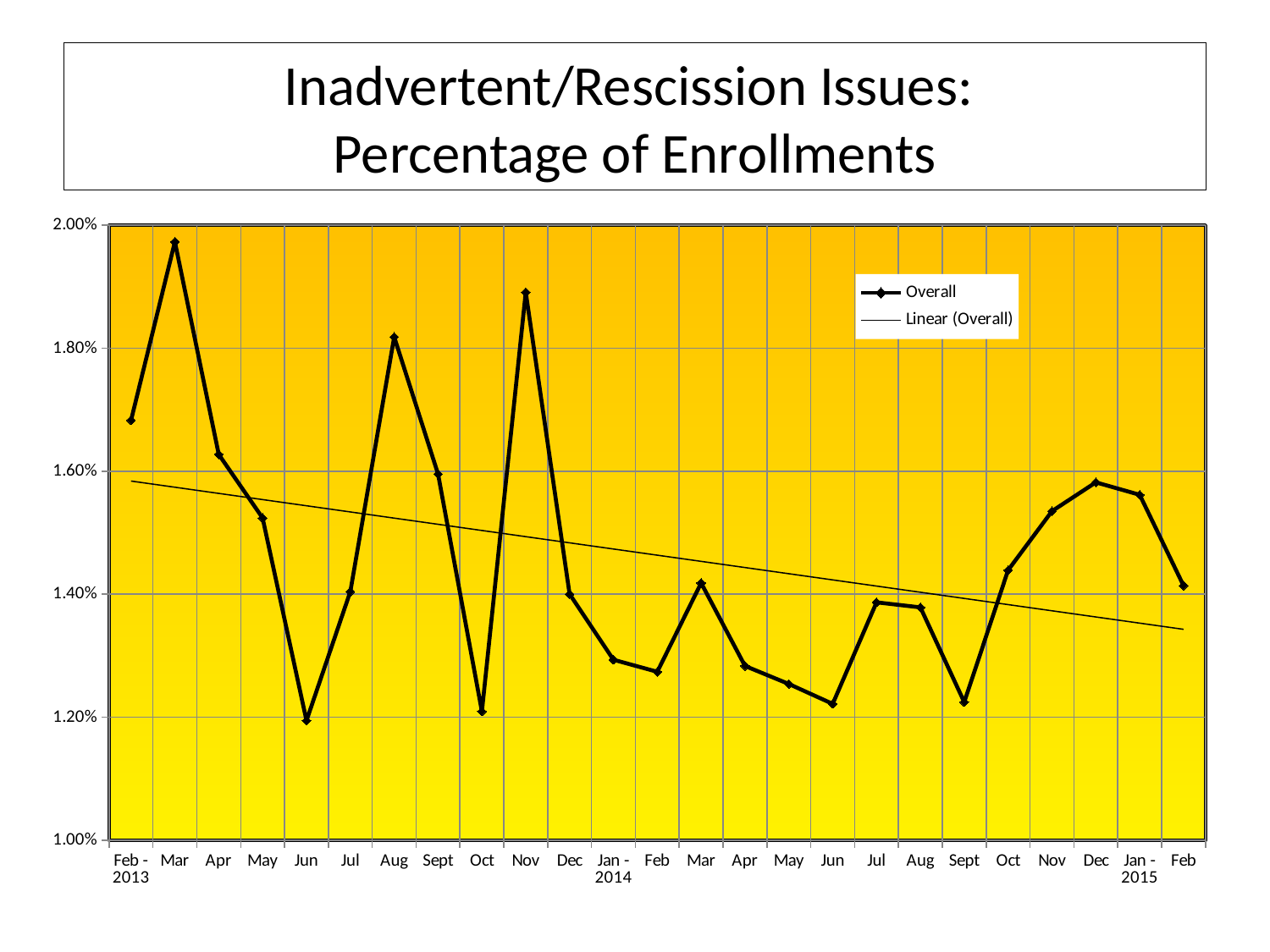
Is the Overall value for Sept 2014 greater or less than 1.40%? less How many entries does the legend list? 2 Which is higher, the Overall value for Mar 2013 or for Nov 2013? Mar 2013 Is the Overall value for Mar 2013 greater or less than 1.80%? greater Which month has the highest Overall value? Mar 2013 Is the Overall value for Jan 2014 greater or less than 1.40%? less What is the title of the chart? Inadvertent/Rescission Issues: Percentage of Enrollments Does the Linear (Overall) trend line rise or fall from left to right? Fall What kind of chart is shown on the slide? Line chart How many data points are plotted on the Overall line? 25